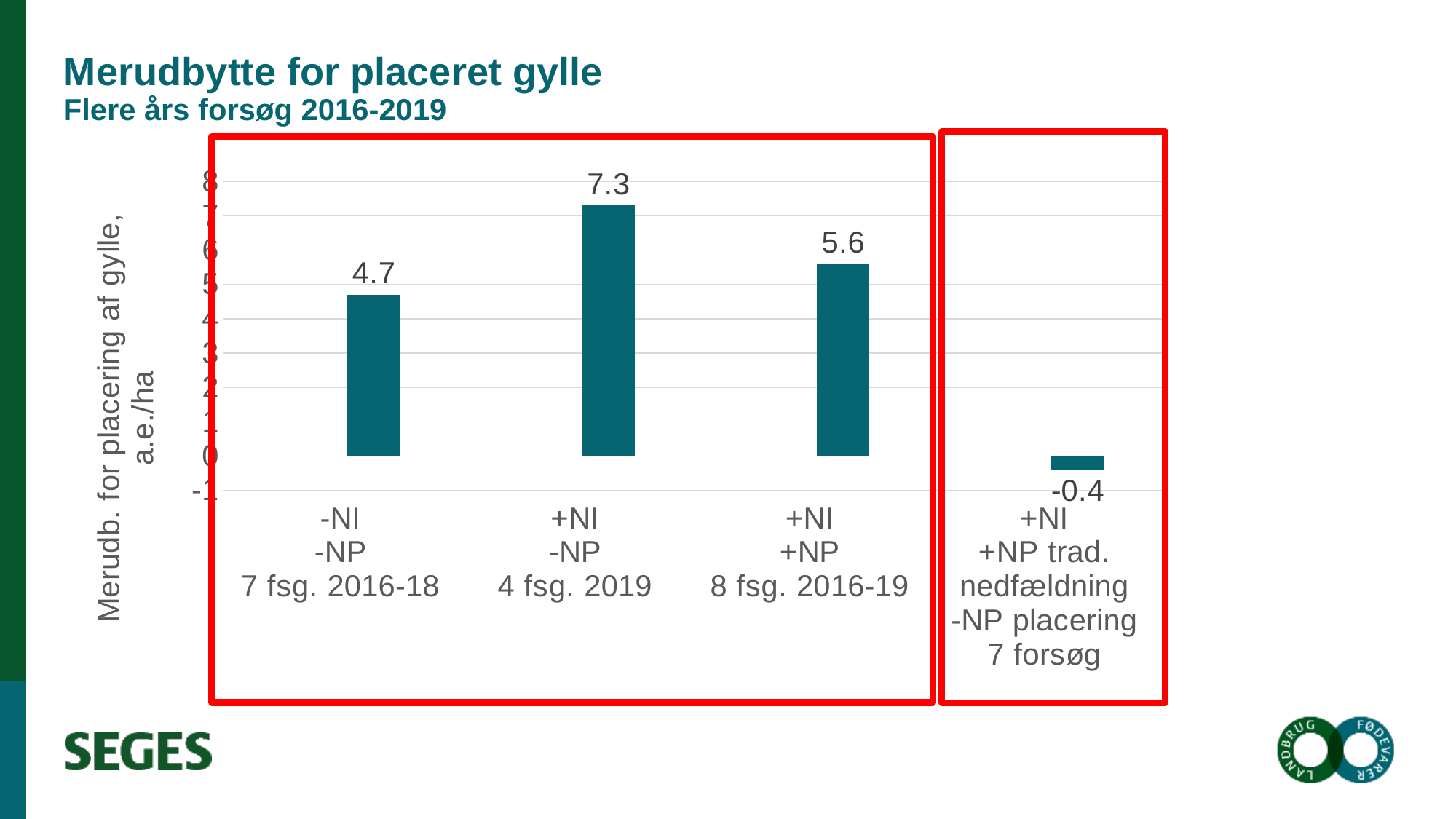
What is the difference between the '+NI -NP 4 fsg. 2019' bar and the '-NI -NP 7 fsg. 2016-18' bar? 2.6 What is the value for the '-NI -NP 7 fsg. 2016-18' bar? 4.7 What is the value for the '+NI -NP 4 fsg. 2019' bar? 7.3 Which is larger: the value for '+NI +NP 8 fsg. 2016-19' or the value for '-NI -NP 7 fsg. 2016-18'? +NI +NP 8 fsg. 2016-19 What is the y-axis label of the chart? Merudb. for placering af gylle, a.e./ha Which category has the lowest value? +NI +NP trad. nedfældning -NP placering 7 forsøg How many bars are shown in the chart? 4 Which category has the highest value? +NI -NP 4 fsg. 2019 What is the value for the '+NI +NP trad. nedfældning -NP placering 7 forsøg' bar? -0.4 What kind of chart is shown on the slide? Bar chart What is the value for the '+NI +NP 8 fsg. 2016-19' bar? 5.6 Is the value for '+NI -NP 4 fsg. 2019' greater or less than 6? greater